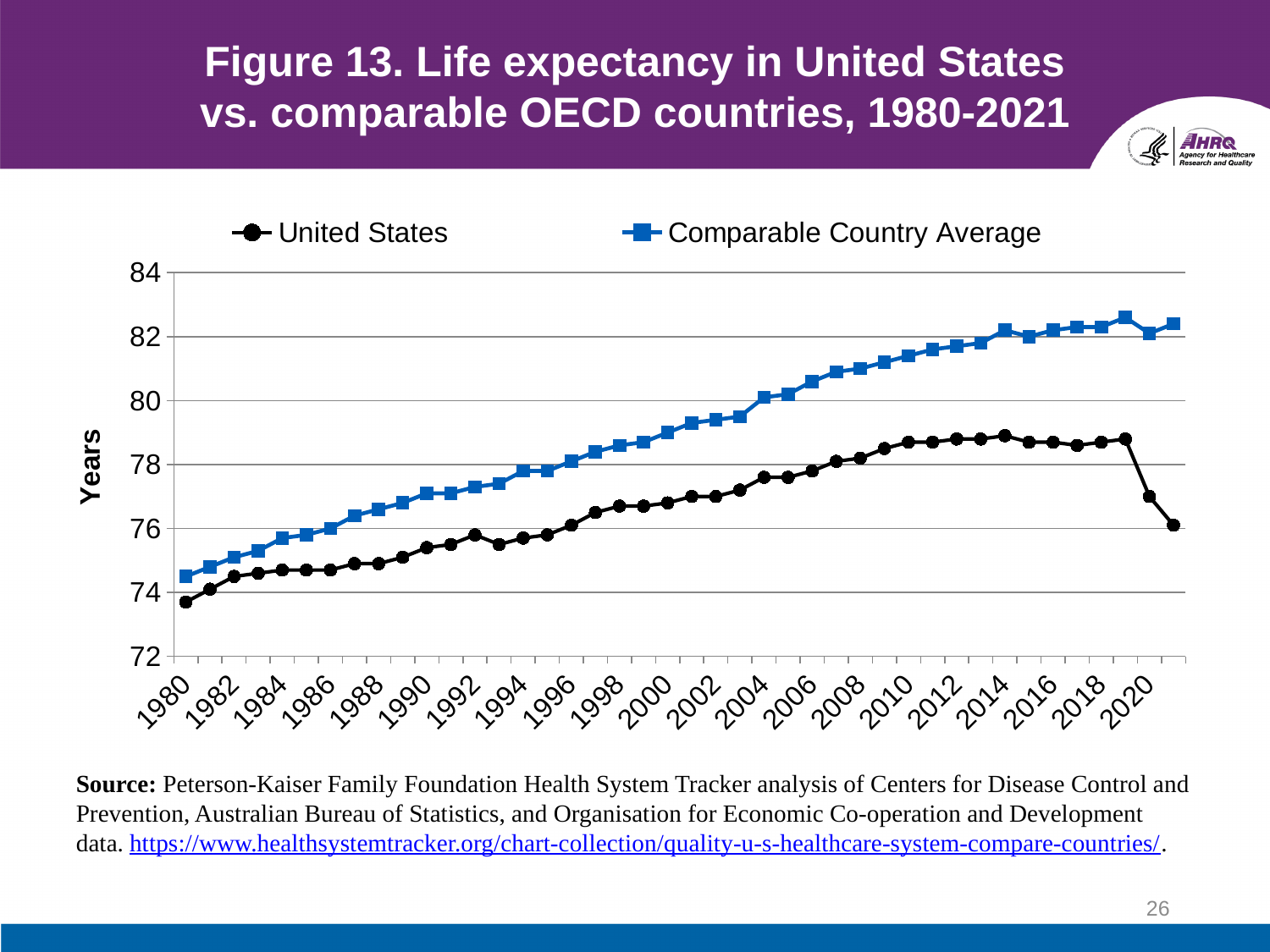
Is the value for United States in 2014 greater or less than 78? greater What is the label on the vertical axis? Years Is the value for Comparable Country Average in 2010 greater or less than 80? greater Does the United States line rise or fall between 2019 and 2021? fall Does the Comparable Country Average line generally rise or fall from 1980 to 2019? rise Is the value for Comparable Country Average in 1980 greater or less than 74? greater How many series does the legend list? 2 Which series has the higher value in 2021, United States or Comparable Country Average? Comparable Country Average What kind of chart is shown on the slide? line chart What are the two series named in the legend? United States and Comparable Country Average